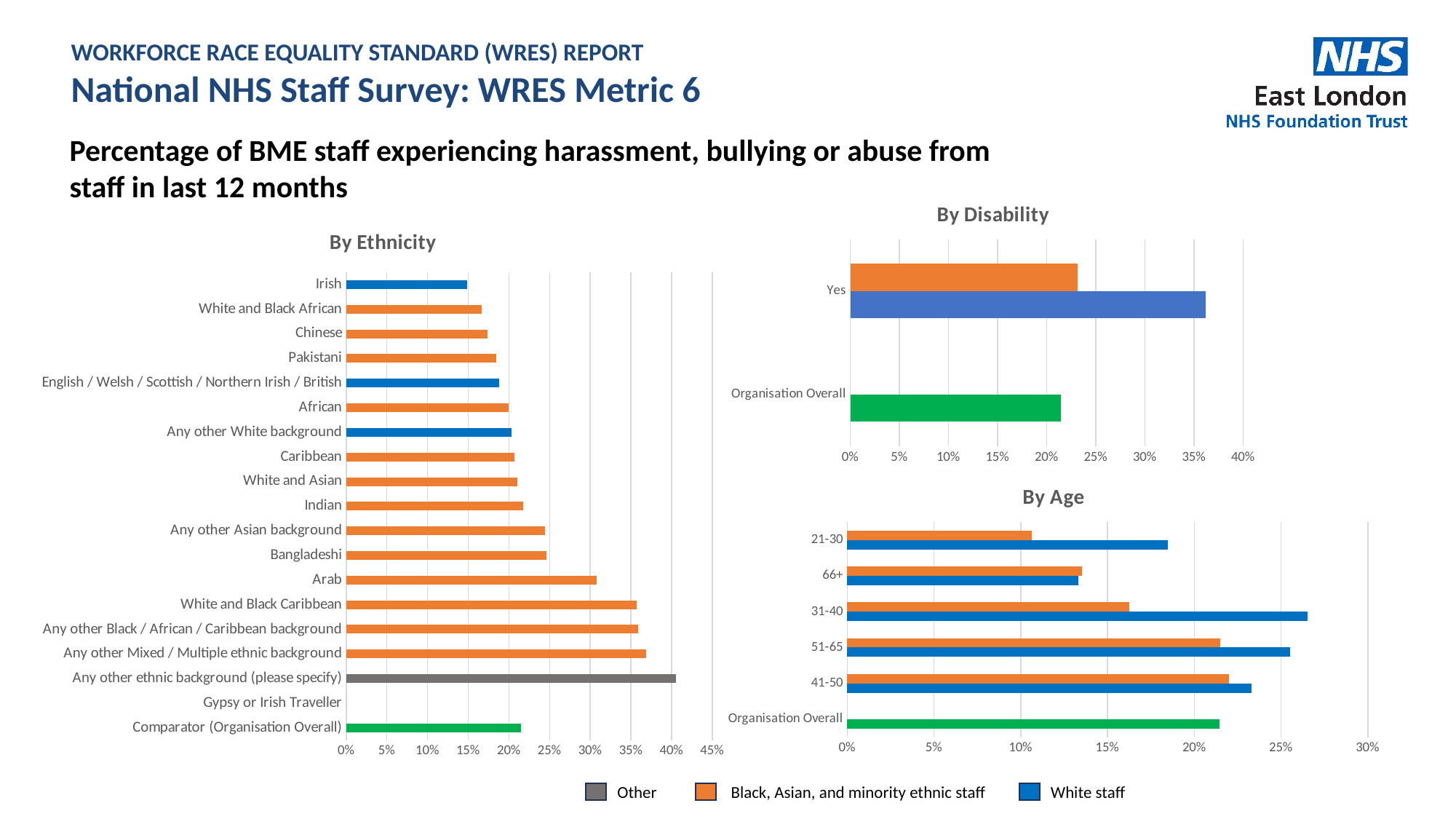
In the 'By Disability' chart, is the White staff value for 'Yes' greater or less than 30%? greater In the 'By Disability' chart, is the Black, Asian, and minority ethnic staff value for 'Yes' greater or less than 25%? less In the 'By Age' chart, which age group has the highest White staff value? 31-40 In the 'By Disability' chart, for 'Yes', which is larger: the White staff value or the Black, Asian, and minority ethnic staff value? White staff How many categories are shown on the y axis of the 'By Age' chart? 6 In the 'By Ethnicity' chart, is the value for Arab greater or less than 25%? greater What kind of chart is the 'By Ethnicity' chart? Bar chart How many series does the legend at the bottom of the slide list? 3 In the 'By Ethnicity' chart, which is larger, the value for Bangladeshi or the value for Indian? Bangladeshi In the 'By Ethnicity' chart, which category has the highest value? Any other ethnic background (please specify)